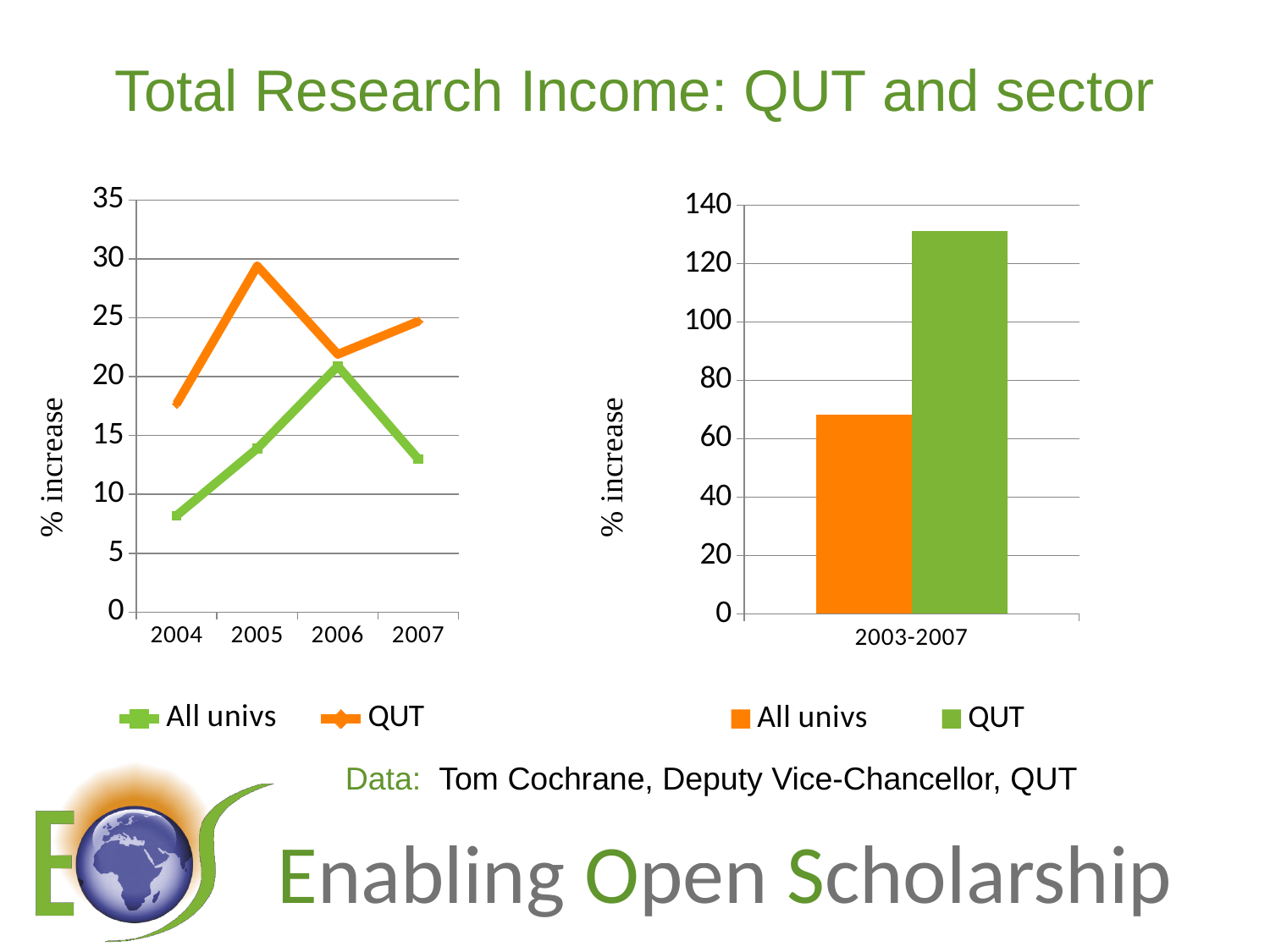
In the left chart, in which year is the QUT value highest? 2005 In the right chart, is the All univs value greater or less than 60? greater In the right chart, is the QUT value greater or less than 120? greater In the left chart, in which year is the All univs value lowest? 2004 What kind of chart is the chart on the right of the slide? bar chart What kind of chart is the chart on the left of the slide? line chart In the left chart, is the QUT value for 2005 greater or less than 25? greater In the left chart, does the All univs value rise or fall from 2006 to 2007? fall In the left chart, how many years are shown on the x axis? 4 In the left chart, how many series does the legend list? 2 In the right chart, which series has the larger value for 2003-2007, All univs or QUT? QUT